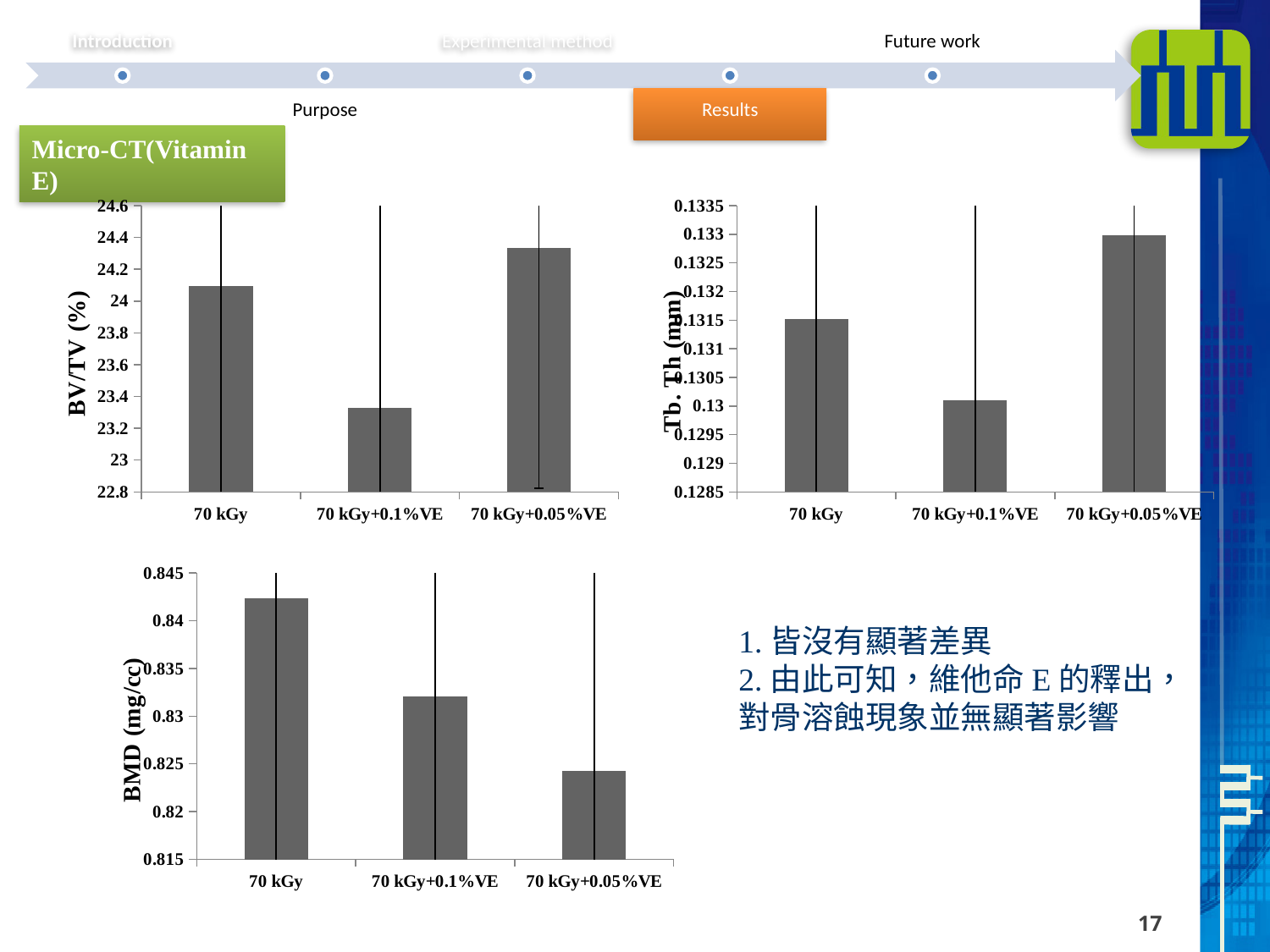
In the BMD (mg/cc) chart, is the value for 70 kGy+0.05%VE greater or less than 0.83? less In the BV/TV (%) chart, which category has the lowest value? 70 kGy+0.1%VE In the Tb. Th (mm) chart, is the value for 70 kGy greater or less than 0.1305? greater In the BV/TV (%) chart, is the value for 70 kGy+0.05%VE greater or less than 24.2? greater In the Tb. Th (mm) chart, which category has the lowest value? 70 kGy+0.1%VE In the BMD (mg/cc) chart, do the values rise or fall from left to right along the x axis? fall In the BMD (mg/cc) chart, which category has the highest value? 70 kGy In the Tb. Th (mm) chart, which category has the highest value? 70 kGy+0.05%VE In the BMD (mg/cc) chart, which category has the lowest value? 70 kGy+0.05%VE In the BV/TV (%) chart, which category has the highest value? 70 kGy+0.05%VE How many categories are shown on the x axis of the BMD (mg/cc) chart? 3